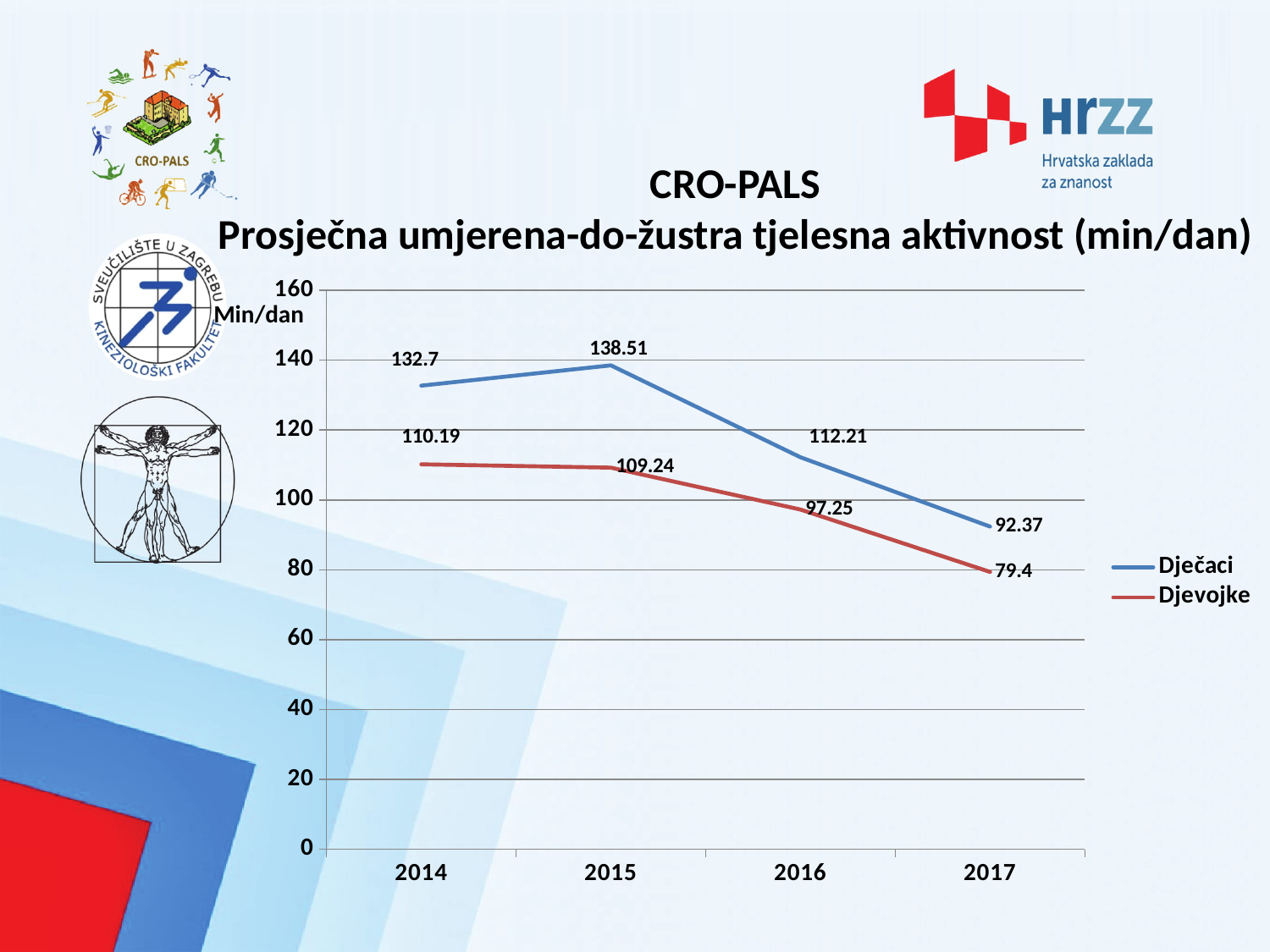
In which year is the value for Dječaci highest? 2015 Which series has the larger value in 2016, Dječaci or Djevojke? Dječaci What is the value for Dječaci in 2014? 132.7 What is the difference between the Dječaci and Djevojke values in 2017? 12.97 Does the value for Djevojke rise or fall from 2014 to 2017? Fall How many series does the legend list? 2 How many years are shown on the x axis? 4 In which year is the value for Djevojke lowest? 2017 What is the value for Djevojke in 2017? 79.4 What is the value for Dječaci in 2015? 138.51 What is the value for Djevojke in 2016? 97.25 What kind of chart is shown on the slide? Line chart